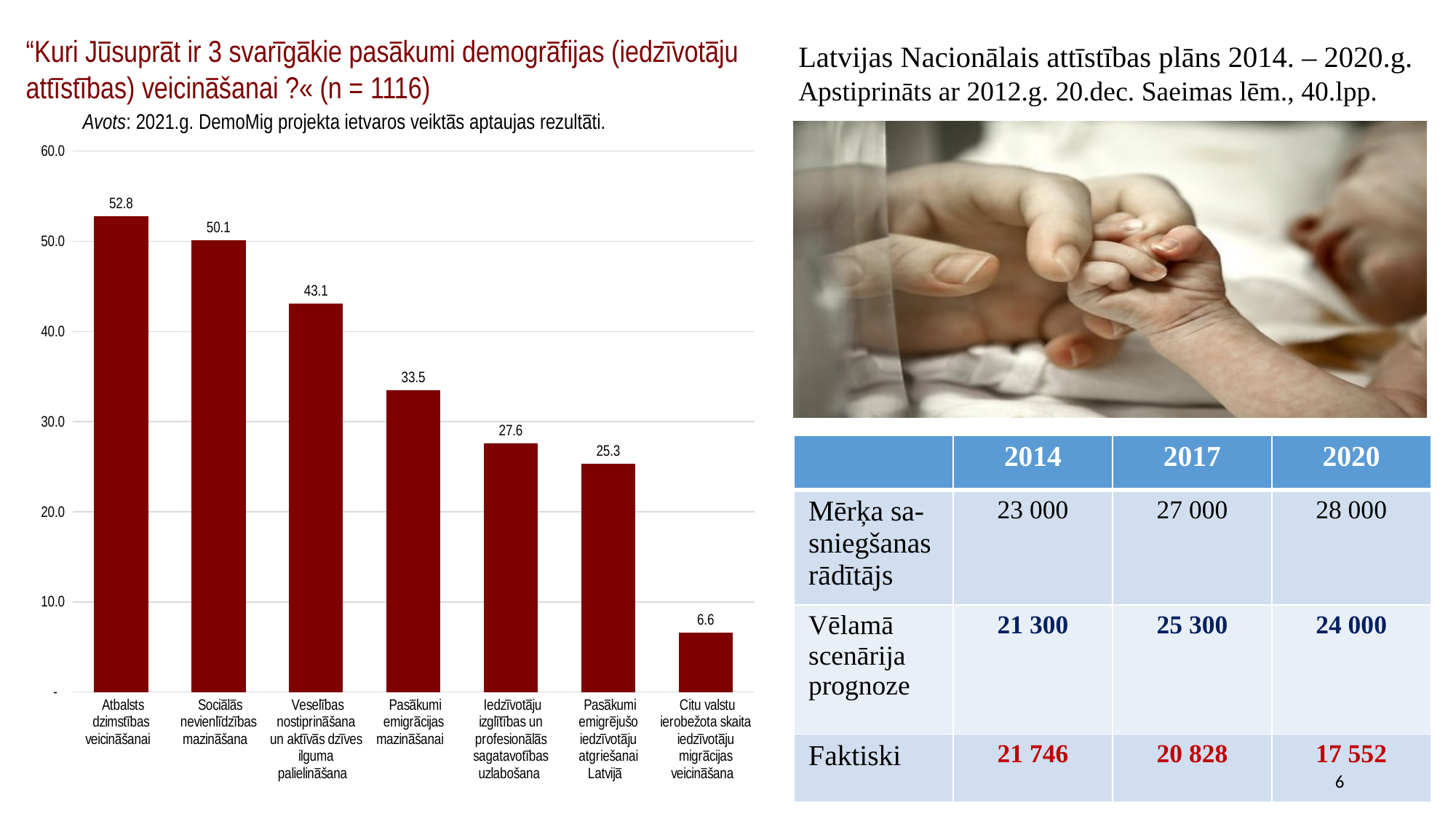
What is the value for "Veselības nostiprināšana un aktīvās dzīves ilguma palielināšana"? 43.1 What kind of chart is shown on the slide? Bar chart Do the values rise or fall from left to right along the x axis? Fall What is the difference between the values for "Iedzīvotāju izglītības un profesionālās sagatavotības uzlabošana" and "Pasākumi emigrējušo iedzīvotāju atgriešanai Latvijā"? 2.3 What is the difference between the values for "Atbalsts dzimstības veicināšanai" and "Sociālās nevienlīdzības mazināšana"? 2.7 Which category has the highest value? Atbalsts dzimstības veicināšanai Which category has the lowest value? Citu valstu ierobežota skaita iedzīvotāju migrācijas veicināšana What is the value for "Citu valstu ierobežota skaita iedzīvotāju migrācijas veicināšana"? 6.6 What is the value for "Atbalsts dzimstības veicināšanai"? 52.8 What is the value for "Pasākumi emigrācijas mazināšanai"? 33.5 How many categories are shown in the bar chart? 7 Which is larger: the value for "Pasākumi emigrācijas mazināšanai" or the value for "Iedzīvotāju izglītības un profesionālās sagatavotības uzlabošana"? Pasākumi emigrācijas mazināšanai